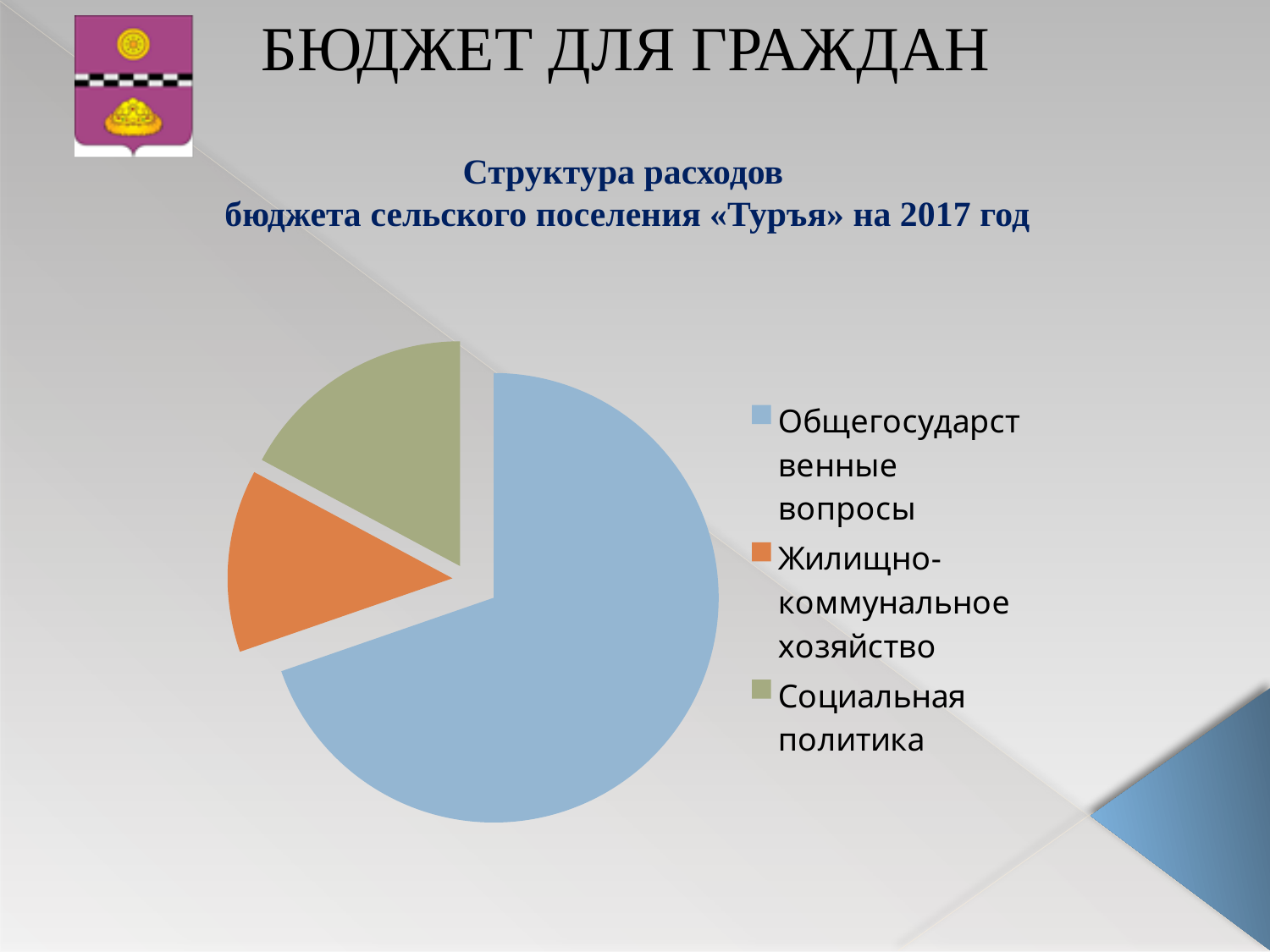
How many entries does the legend of the pie chart list? 3 Which slice is larger: Социальная политика or Жилищно-коммунальное хозяйство? Социальная политика Does the slice for Общегосударственные вопросы take up more or less than half of the pie? more What colour is the slice for Жилищно-коммунальное хозяйство? orange Which category has the smallest slice of the pie chart? Жилищно-коммунальное хозяйство How many slices does the pie chart have? 3 Which category has the largest slice of the pie chart? Общегосударственные вопросы Which category is shown in green on the pie chart? Социальная политика Which slice is larger: Общегосударственные вопросы or Социальная политика? Общегосударственные вопросы What kind of chart is shown on the slide? pie chart